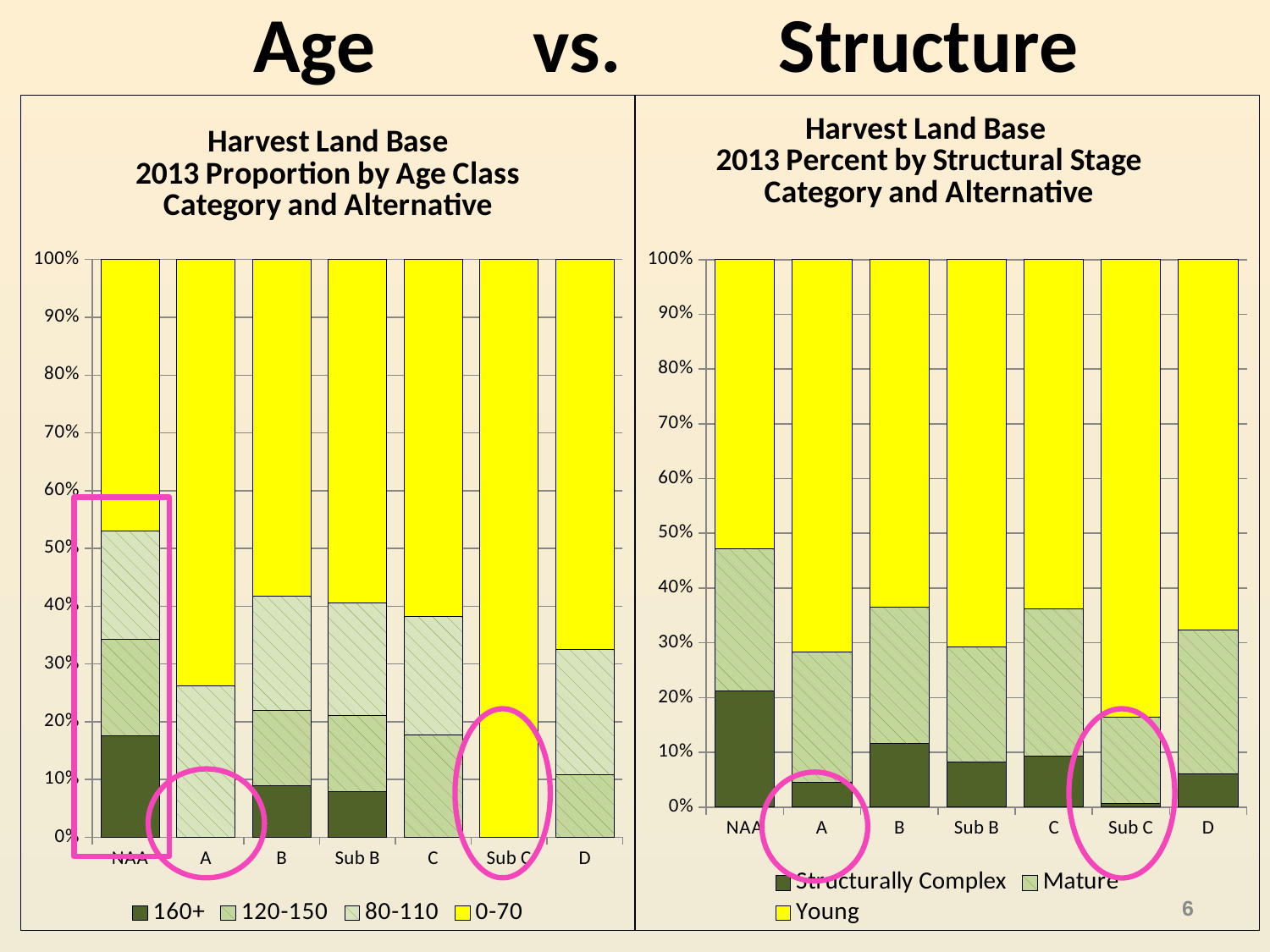
On the right chart (Percent by Structural Stage), which alternative has the largest Structurally Complex share? NAA On the right chart (Percent by Structural Stage), which has the larger Structurally Complex share, B or Sub B? B On the right chart (Percent by Structural Stage), is the Young share for Sub C greater or less than 80%? greater On the left chart (Proportion by Age Class), which alternative has the largest 0-70 share? Sub C On the left chart (Proportion by Age Class), which alternative has the smallest 0-70 share? NAA On the left chart (Proportion by Age Class), how many age class series does the legend list? 4 On the left chart (Proportion by Age Class), is the 160+ share for NAA greater or less than 10%? greater On the right chart (Percent by Structural Stage), how many series does the legend list? 3 On the left chart (Proportion by Age Class), how many alternatives are shown along the x axis? 7 On the right chart (Percent by Structural Stage), which colour represents the Young series? Yellow On the right chart (Percent by Structural Stage), which alternative has the smallest Structurally Complex share? Sub C On the left chart (Harvest Land Base 2013 Proportion by Age Class), what kind of chart is shown? Stacked bar chart